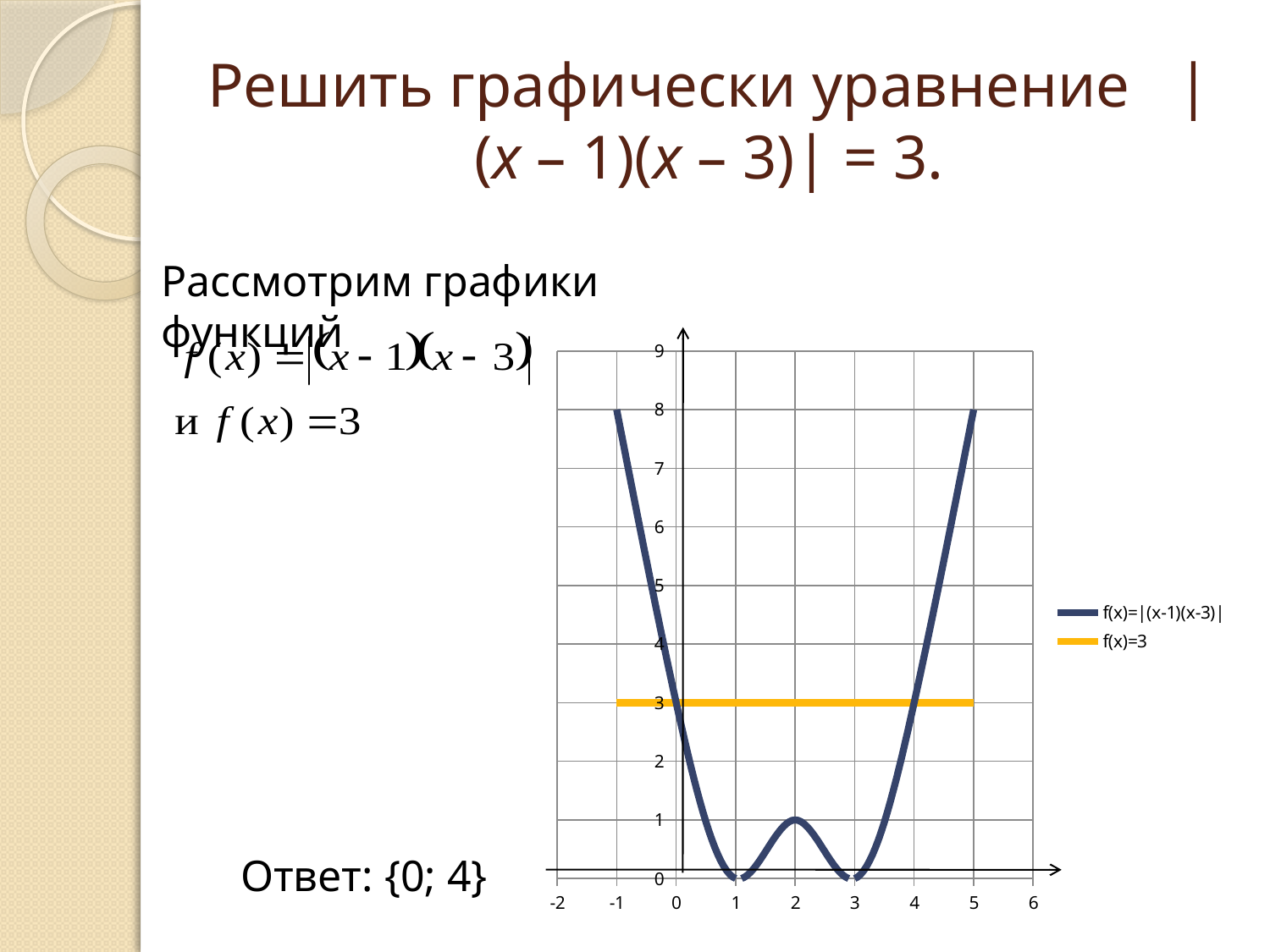
What kind of chart is shown on the slide? line chart Which series has the larger value at x = 2, f(x)=|(x-1)(x-3)| or f(x)=3? f(x)=3 What is the value of f(x)=|(x-1)(x-3)| at x = 5? 8 What is the highest value shown on the vertical axis of the chart? 9 What are the two series named in the chart legend? f(x)=|(x-1)(x-3)| and f(x)=3 What colour is the line for the series f(x)=3? yellow What is the value of f(x)=|(x-1)(x-3)| at x = 0? 3 Does the curve f(x)=|(x-1)(x-3)| rise or fall as x goes from 3 to 5? rise How many series does the chart legend list? 2 What is the value of f(x)=|(x-1)(x-3)| at x = 1? 0 What is the value of f(x)=|(x-1)(x-3)| at x = 2? 1 Is the value of f(x)=|(x-1)(x-3)| at x = -1 greater or less than 5? greater